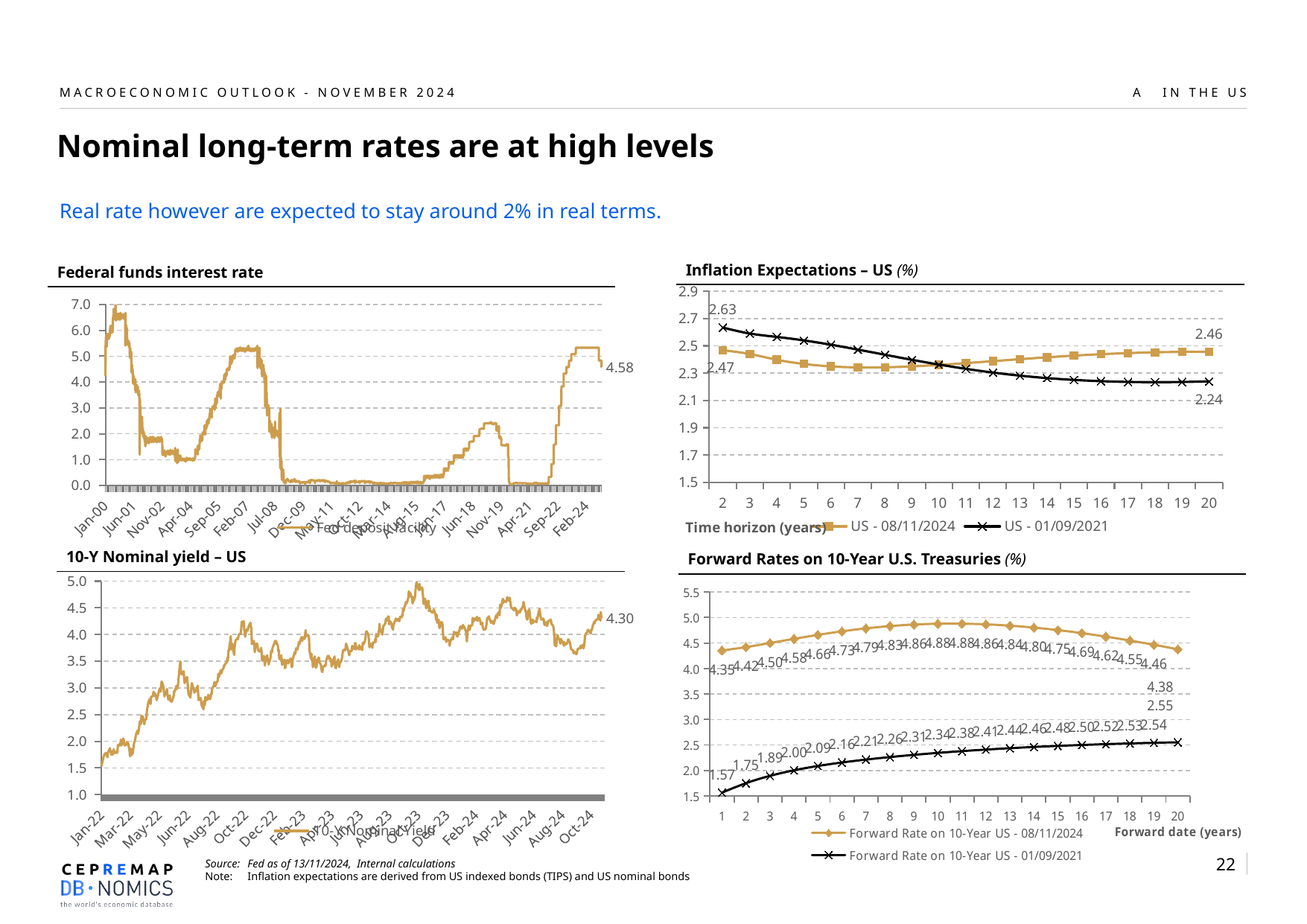
On the Inflation Expectations – US chart, what is the value of the US - 08/11/2024 series at a time horizon of 20 years? 2.46 On the Inflation Expectations – US chart, does the US - 01/09/2021 series rise or fall as the time horizon increases? fall What kind of chart is the 10-Y Nominal yield – US chart? line chart On the 10-Y Nominal yield – US chart, what is the latest value labelled at the end of the line? 4.30 On the Forward Rates on 10-Year U.S. Treasuries chart, what is the lowest value of the 01/09/2021 series? 1.57 How many series does the legend of the Inflation Expectations – US chart list? 2 On the Forward Rates on 10-Year U.S. Treasuries chart, what is the value of the 08/11/2024 series at a forward date of 1 year? 4.35 On the Inflation Expectations – US chart, what is the value of the US - 01/09/2021 series at a time horizon of 2 years? 2.63 On the Forward Rates on 10-Year U.S. Treasuries chart, how many forward dates (years) are plotted on the x axis? 20 On the Forward Rates on 10-Year U.S. Treasuries chart, what is the highest value reached by the 08/11/2024 series? 4.88 On the Federal funds interest rate chart, what is the latest value labelled at the end of the line? 4.58 On the Inflation Expectations – US chart, what is the difference between the two series at a time horizon of 20 years (2.46 vs 2.24)? 0.22